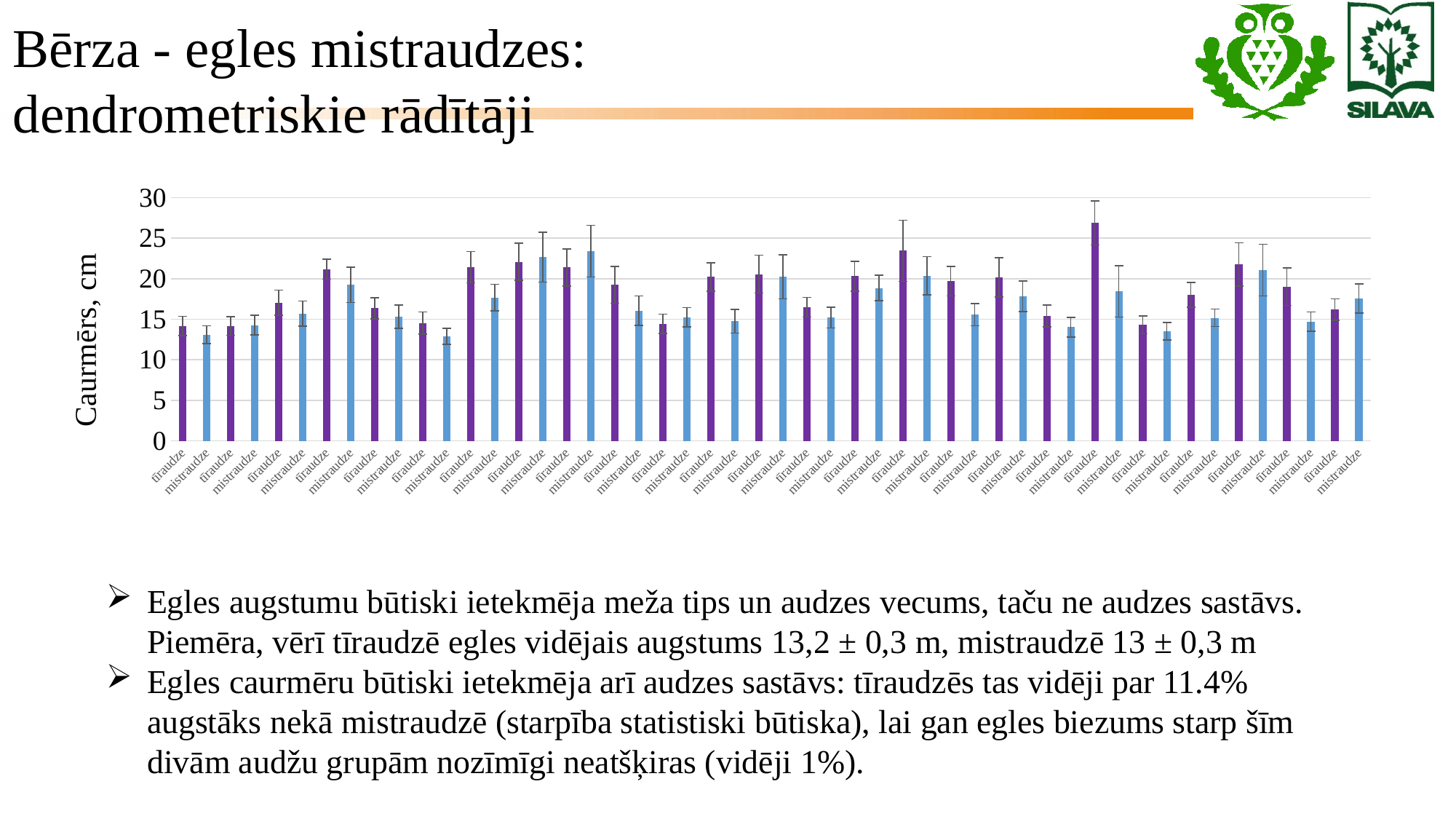
Is the value of the tallest bar in the chart greater or less than 25? greater What kind of chart is shown on the slide? bar chart What is the label of the vertical axis of the chart? Caurmērs, cm Is the value of the shortest bar in the chart greater or less than 15? less What is the highest tick value shown on the vertical axis of the chart? 30 Is the value of the shortest bar in the chart greater or less than 10? greater What colour are the bars labelled tīraudze in the chart? purple How many distinct category labels are used on the x axis of the chart? 2 Is the tallest bar in the chart a tīraudze bar or a mistraudze bar? tīraudze